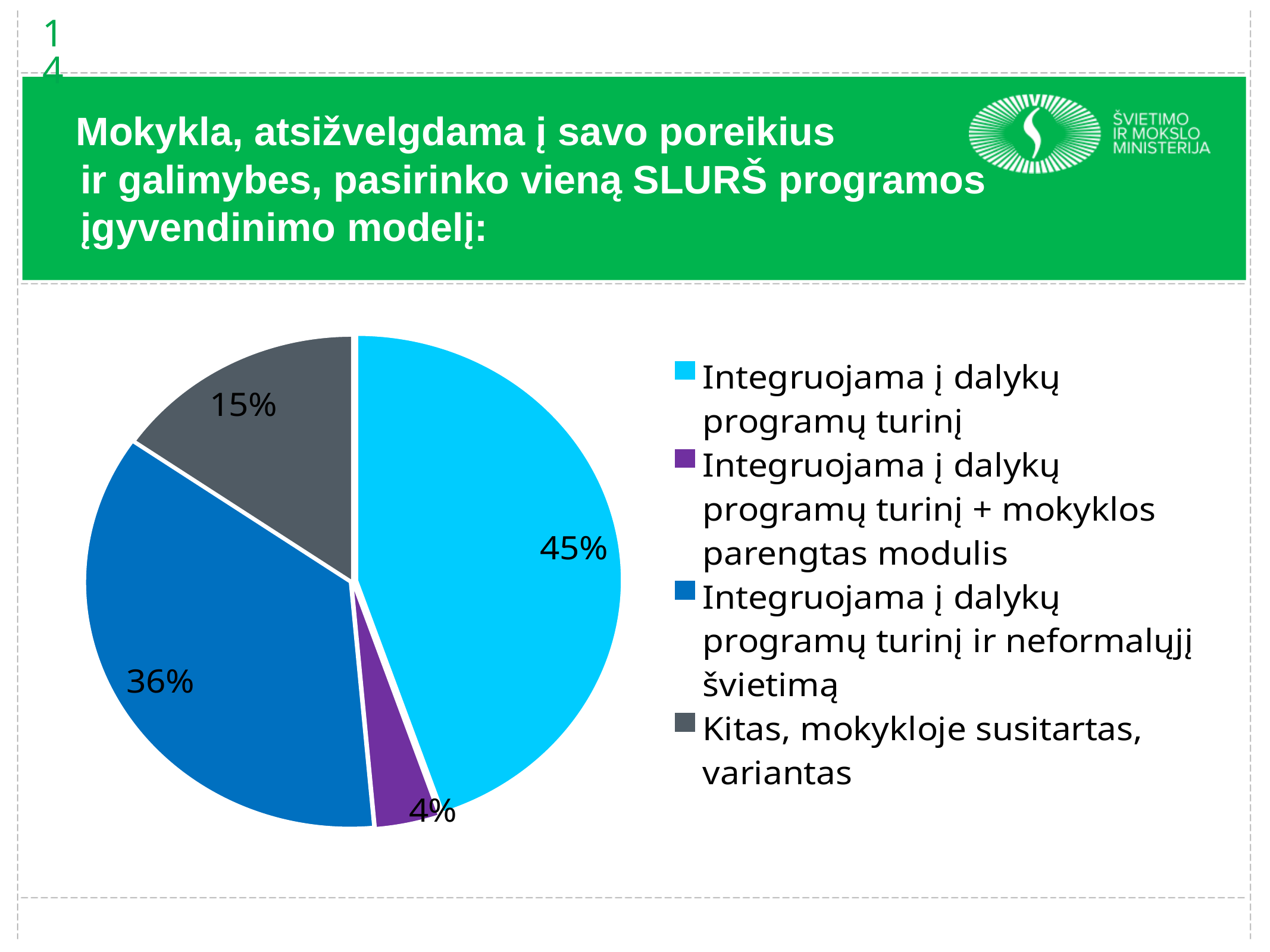
Which category has the smallest slice of the pie? Integruojama į dalykų programų turinį + mokyklos parengtas modulis What kind of chart is shown on the slide? pie chart What share of the pie is labelled "Kitas, mokykloje susitartas, variantas"? 15% What share of the pie is labelled "Integruojama į dalykų programų turinį"? 45% What share of the pie is labelled "Integruojama į dalykų programų turinį + mokyklos parengtas modulis"? 4% Which is larger: the "Kitas, mokykloje susitartas, variantas" slice or the "Integruojama į dalykų programų turinį + mokyklos parengtas modulis" slice? Kitas, mokykloje susitartas, variantas What share of the pie is labelled "Integruojama į dalykų programų turinį ir neformalųjį švietimą"? 36% What is the difference in percentage points between the "Integruojama į dalykų programų turinį" slice and the "Integruojama į dalykų programų turinį ir neformalųjį švietimą" slice? 9 What colour is the slice for "Kitas, mokykloje susitartas, variantas"? grey How many slices does the pie chart have? 4 Which category has the largest slice of the pie? Integruojama į dalykų programų turinį How many entries does the legend list? 4